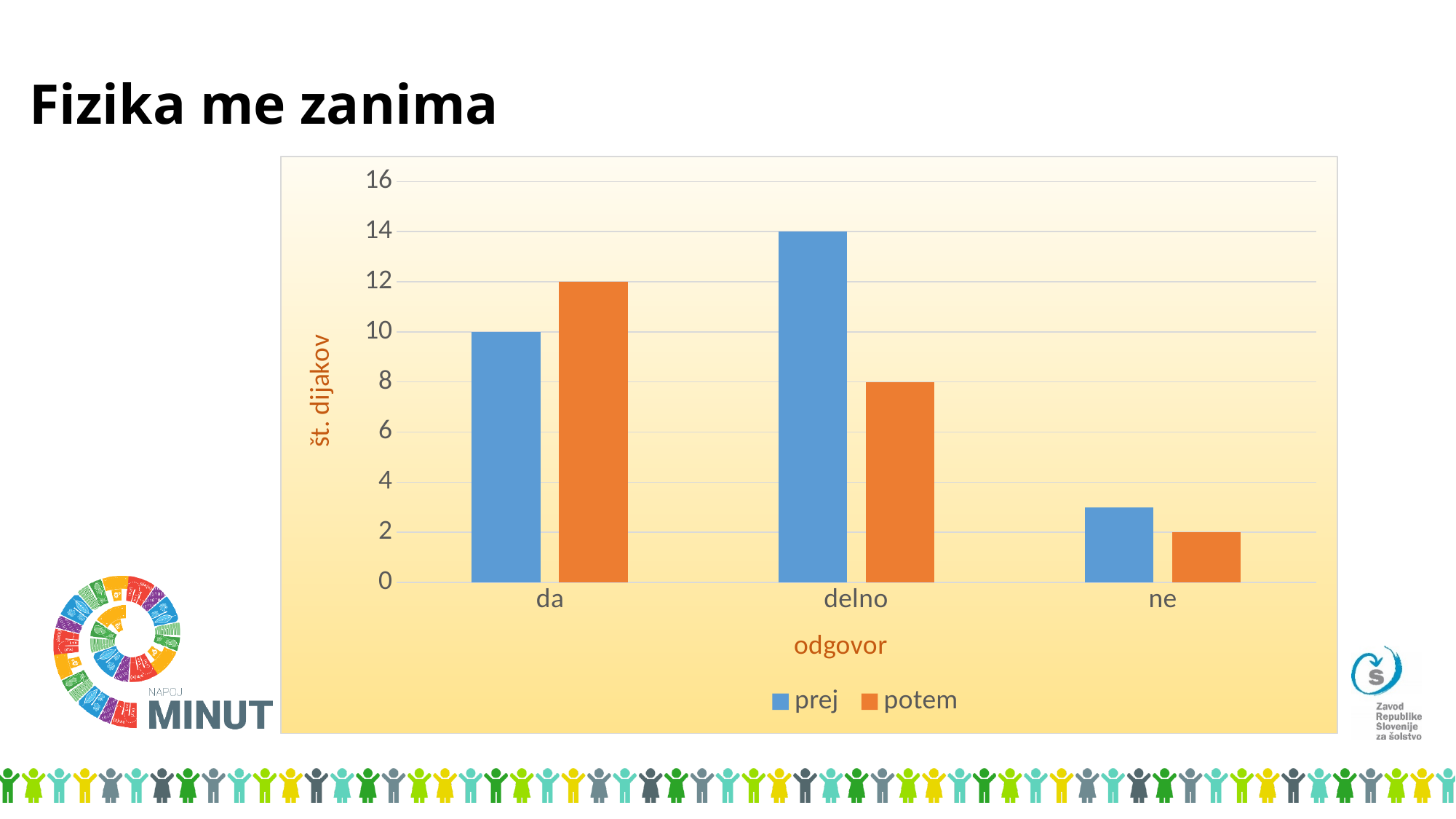
Is the 'prej' value for 'ne' greater or less than 4? less How many categories are shown on the x axis? 3 How many series does the legend list? 2 What is the difference between 'prej' and 'potem' for 'delno'? 6 What is the value of 'prej' for 'delno'? 14 What is the value of 'potem' for 'da'? 12 Which category has the highest 'prej' value? delno What is the value of 'prej' for 'da'? 10 What is the value of 'potem' for 'delno'? 8 What is the value of 'potem' for 'ne'? 2 Which category has the lowest 'potem' value? ne What kind of chart is shown on the slide? bar chart